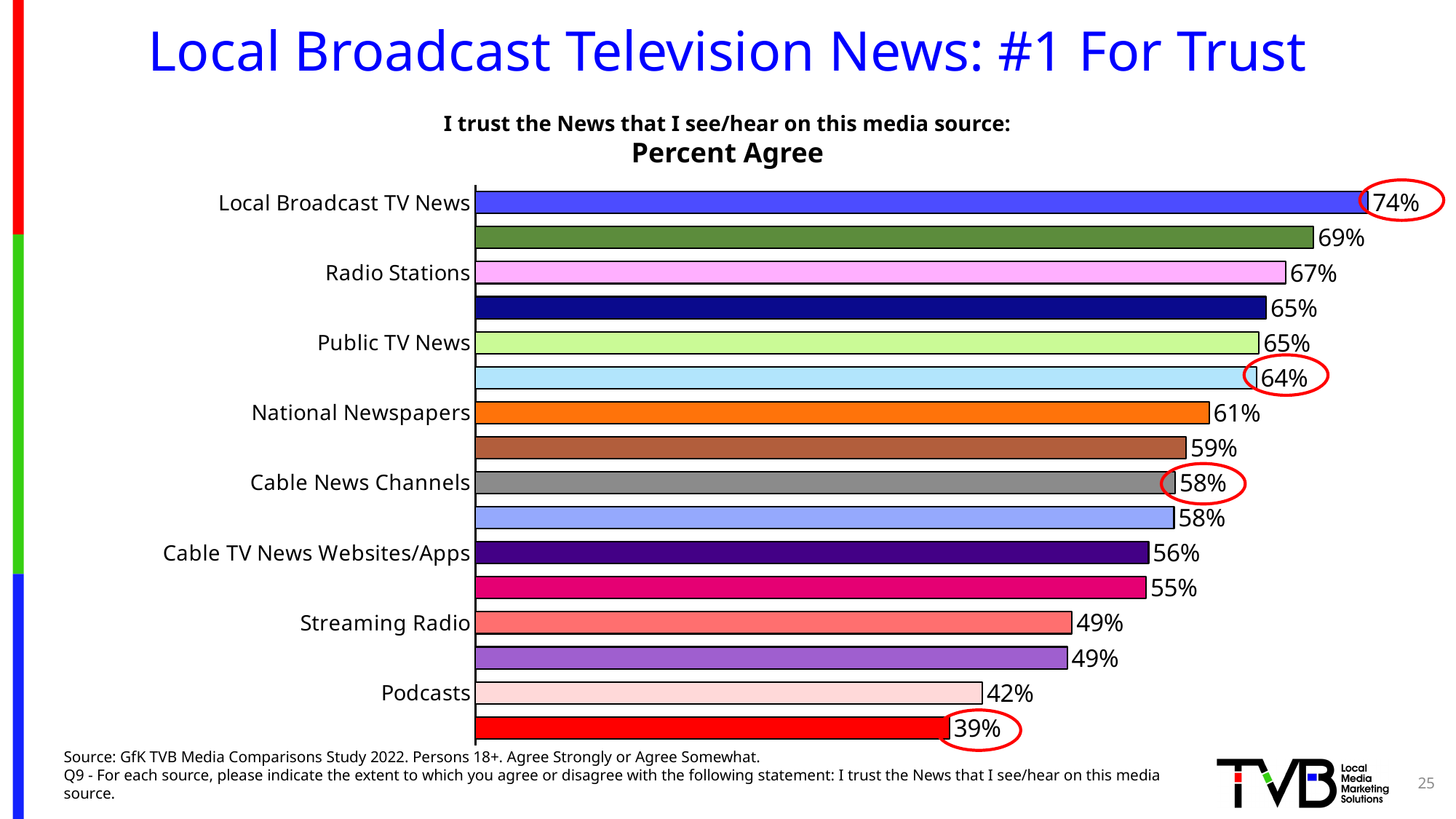
What percent agree that they trust the news on Local Broadcast TV News? 74% How many bars are plotted in the chart? 16 What is the value shown on the shortest bar in the chart? 39% What is the percent agree value for Cable TV News Websites/Apps? 56% What is the difference in percent agree between Local Broadcast TV News and Cable News Channels? 16 percentage points Which has a higher percent agree: National Newspapers or Streaming Radio? National Newspapers What is the percent agree value for Podcasts? 42% What is the percent agree value for Radio Stations? 67% What is the percent agree value for Public TV News? 65% Which media source has the highest percent agree for trust? Local Broadcast TV News What type of chart is shown on the slide? Bar chart What is the subtitle statement shown above the chart? I trust the News that I see/hear on this media source: Percent Agree